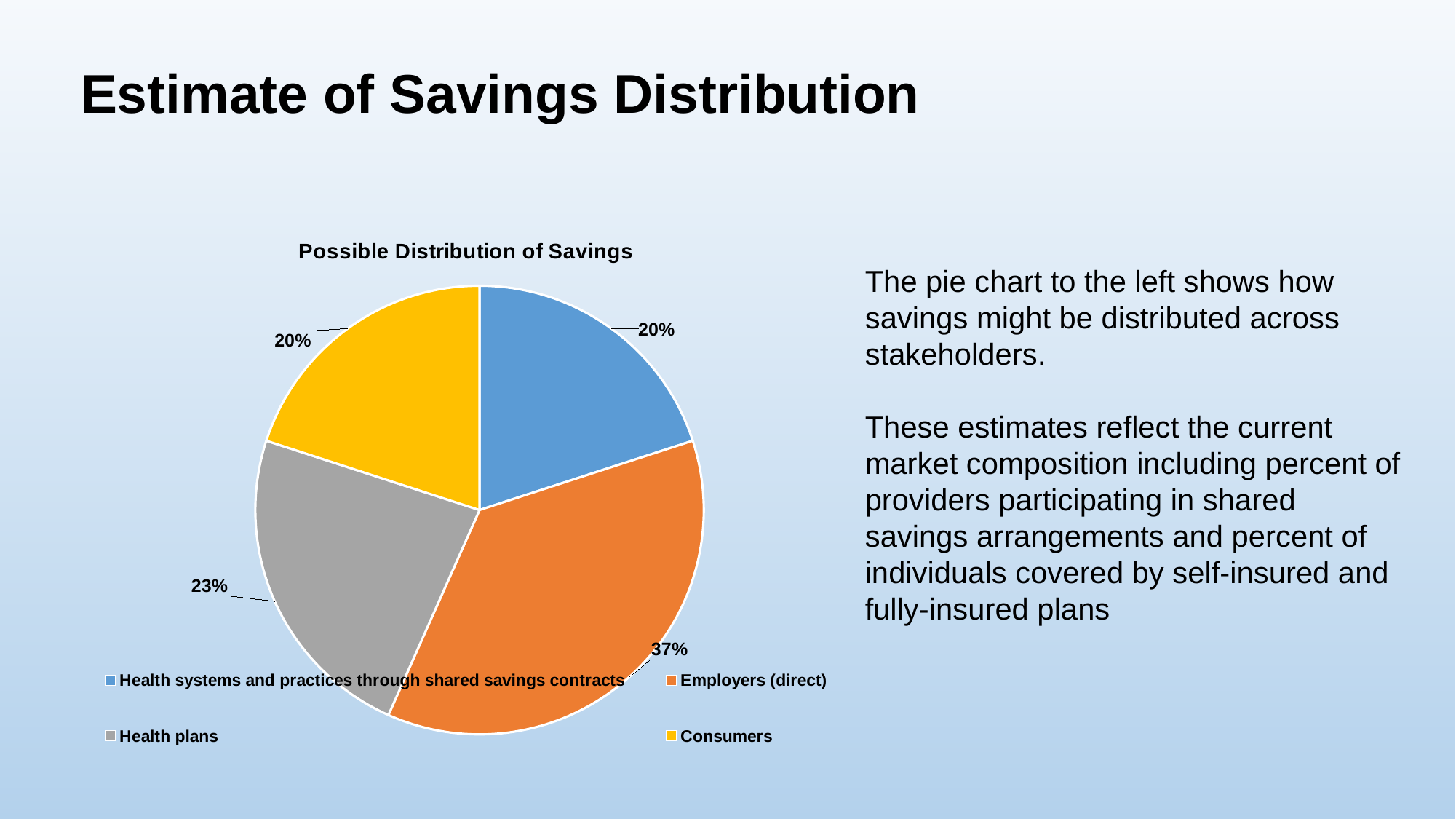
What is the title of the chart? Possible Distribution of Savings What share of savings goes to Consumers? 20% What kind of chart is shown on the slide? pie chart What share of savings goes to Health systems and practices through shared savings contracts? 20% What is the difference between the Employers (direct) share and the Health plans share? 14% How many entries does the legend list? 4 Which stakeholder receives the largest share of savings? Employers (direct) How many slices does the pie chart have? 4 What share of savings goes to Employers (direct)? 37% What share of savings goes to Health plans? 23% What colour is the Employers (direct) slice? orange Which is larger, the share for Health plans or the share for Consumers? Health plans